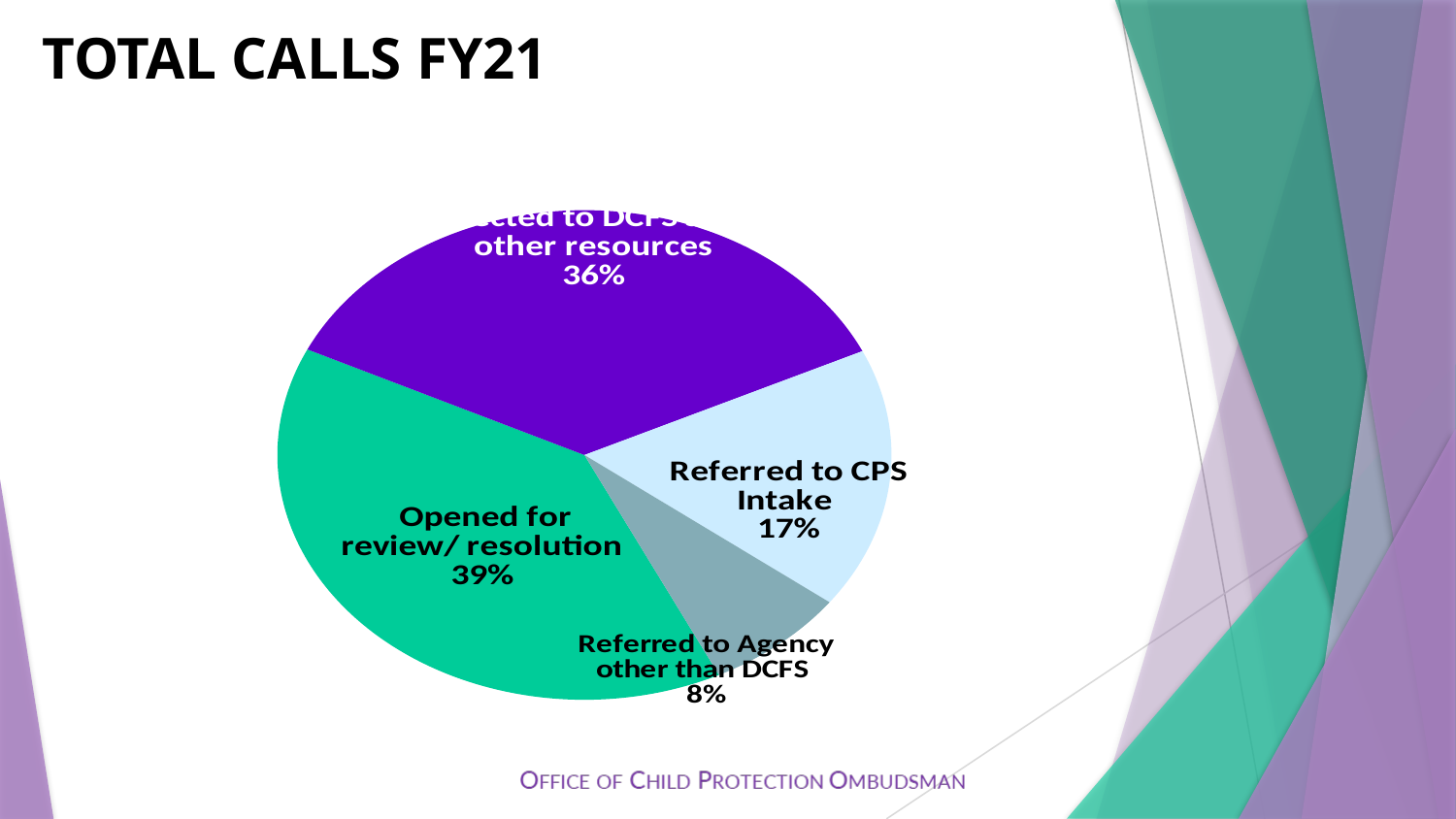
How many slices does the pie chart have? 4 What is the difference in percentage points between Opened for review/resolution and Referred to CPS Intake? 22 What colour is the slice for Opened for review/resolution? green What percentage of calls were Opened for review/resolution? 39% Which is larger: the share Referred to CPS Intake or the share Referred to Agency other than DCFS? Referred to CPS Intake Which category has the smallest share of the pie? Referred to Agency other than DCFS What kind of chart is shown on the slide? pie chart What is the title of the chart on the slide? TOTAL CALLS FY21 What percentage of calls were Referred to CPS Intake? 17% What percentage is shown on the purple slice of the pie chart? 36% What percentage of calls were Referred to Agency other than DCFS? 8% Which category has the largest share of the pie? Opened for review/resolution